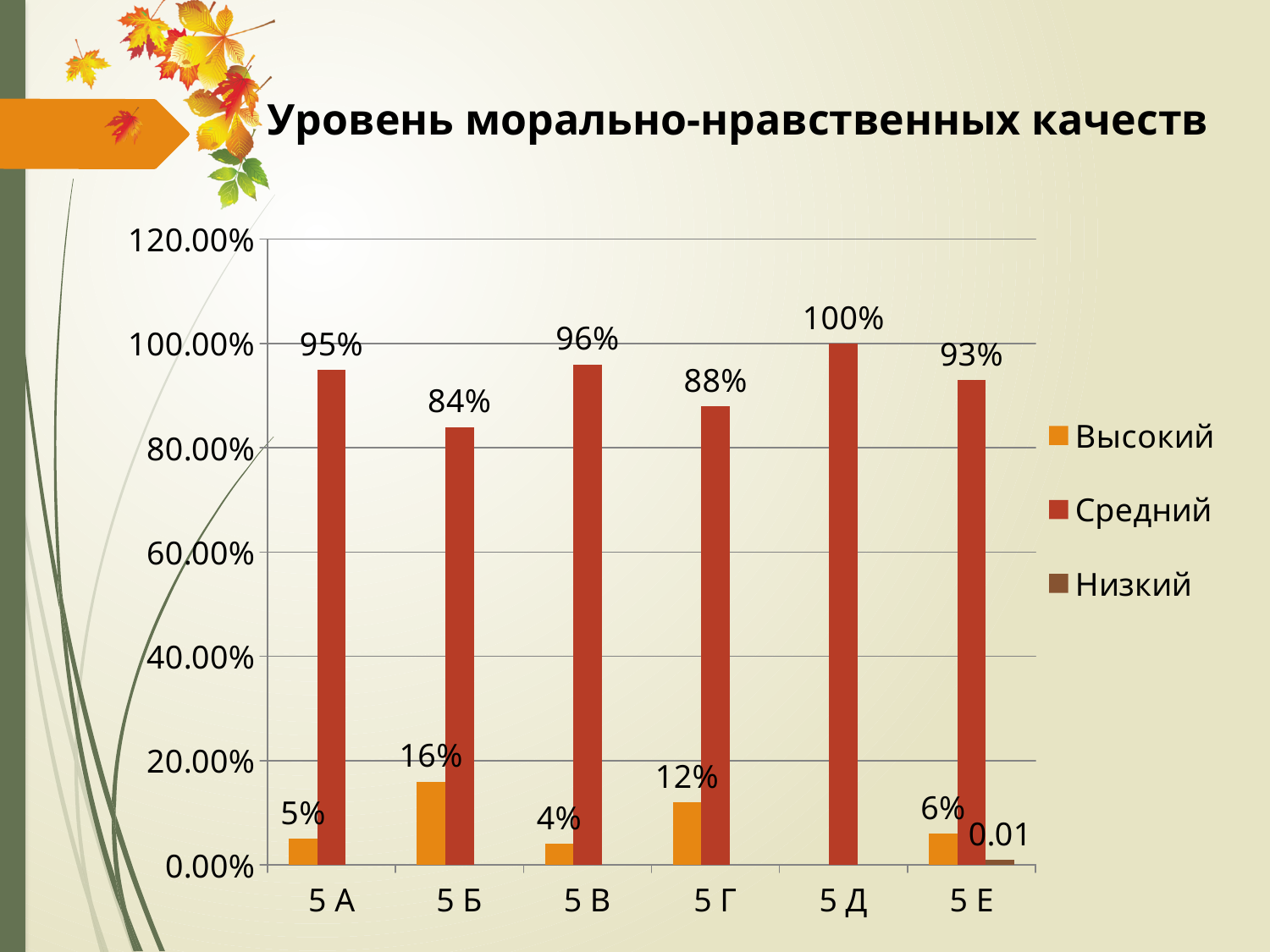
What is the value of Высокий for 5 Б? 16% What is the value of Средний for 5 А? 95% Which is larger, the Высокий value for 5 Г or for 5 Е? 5 Г What is the value of Низкий for 5 Е? 0.01 What is the difference between the Средний values for 5 В and 5 Б? 12% Which category has the lowest Высокий value among those with a labelled Высокий bar? 5 В How many categories are shown on the x axis? 6 What is the title of the chart? Уровень морально-нравственных качеств Is the Средний value for 5 Г greater or less than 80.00%? greater What kind of chart is shown on the slide? bar chart Which category has the highest Средний value? 5 Д How many series does the legend list? 3